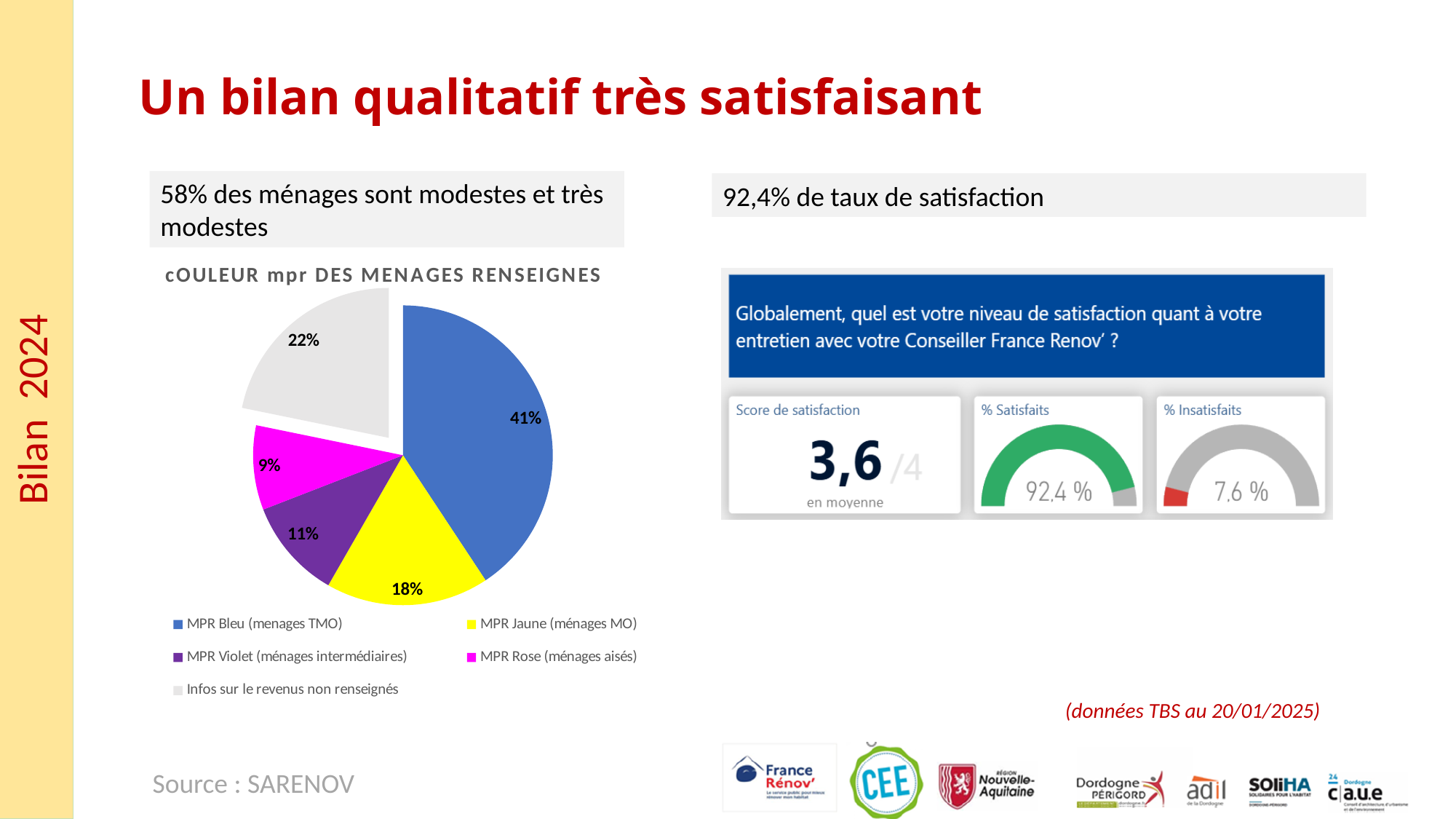
In the pie chart, what share is shown for MPR Violet (ménages intermédiaires)? 11% How many categories does the pie chart legend list? 5 Which category has the largest slice in the pie chart? MPR Bleu (menages TMO) What kind of chart is the 'cOULEUR mpr DES MENAGES RENSEIGNES' chart? Pie chart In the pie chart, what is the difference in percentage points between MPR Bleu and MPR Jaune? 23 In the pie chart, what share is shown for MPR Rose (ménages aisés)? 9% In the pie chart, what share is shown for 'Infos sur le revenus non renseignés'? 22% In the satisfaction dashboard on the right, what value does the '% Satisfaits' gauge show? 92,4 % In the pie chart, what share is shown for MPR Bleu (menages TMO)? 41% Which category has the smallest slice in the pie chart? MPR Rose (ménages aisés) In the pie chart, which is larger: the slice for MPR Violet or the slice for MPR Rose? MPR Violet In the pie chart, what share is shown for MPR Jaune (ménages MO)? 18%